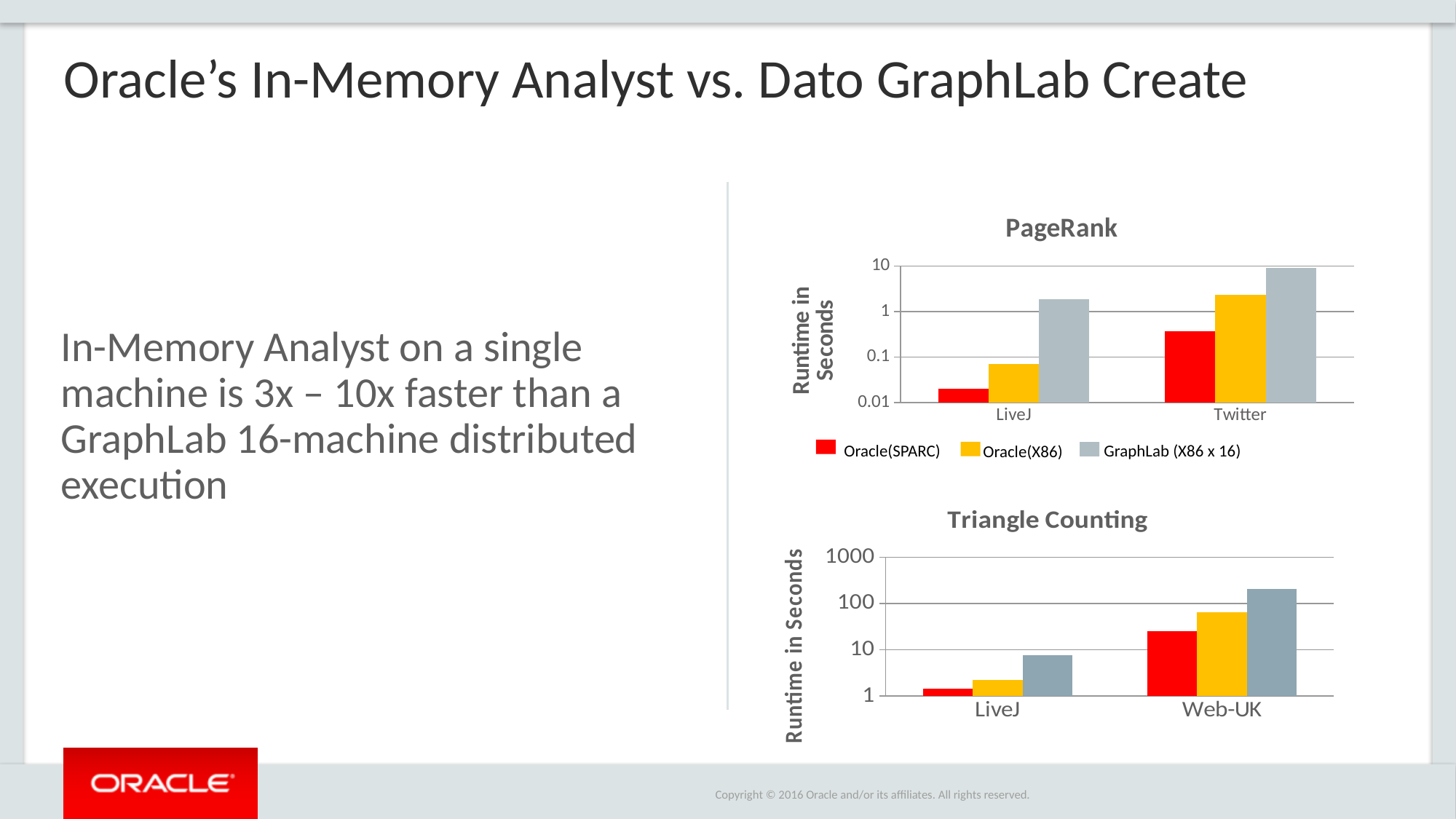
In the PageRank chart, is the value for Oracle(SPARC) on LiveJ greater or less than 0.1? less What kind of chart is the PageRank chart? bar chart In the PageRank chart, is the value for Oracle(SPARC) on Twitter greater or less than 1? less In the PageRank chart, which series has the highest runtime for Twitter? GraphLab (X86 x 16) How many categories are shown on the x axis of the Triangle Counting chart? 2 In the Triangle Counting chart, which is larger for LiveJ: Oracle(X86) or GraphLab (X86 x 16)? GraphLab (X86 x 16) In the Triangle Counting chart, is the value for GraphLab (X86 x 16) on Web-UK greater or less than 100? greater What is the y-axis label of the Triangle Counting chart? Runtime in Seconds How many series does the legend list for the PageRank chart? 3 In the PageRank chart, which series has the lowest runtime for LiveJ? Oracle(SPARC)